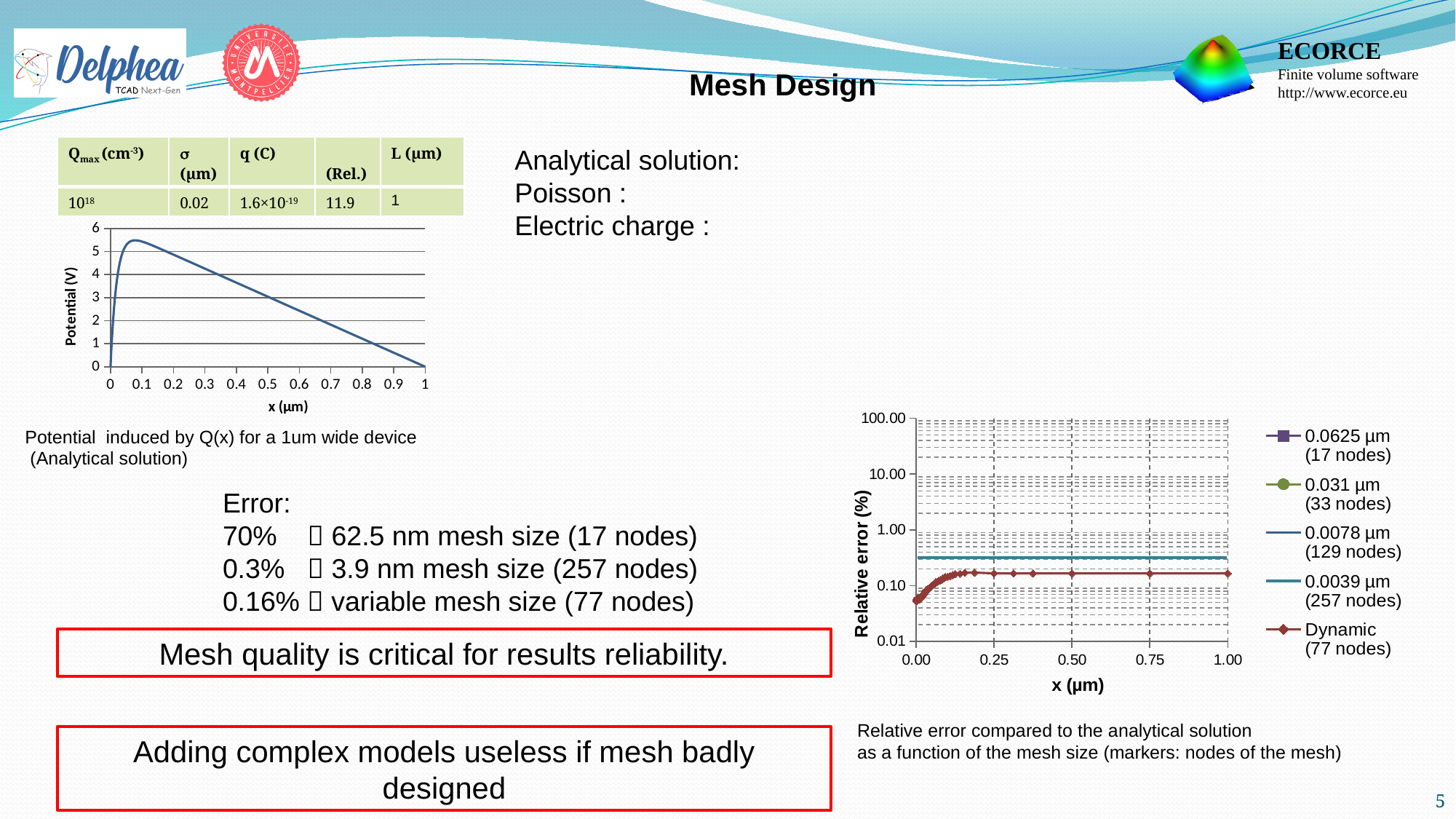
In the right Relative error (%) chart, which series has the larger value at x = 0.50 µm: 0.0039 µm (257 nodes) or Dynamic (77 nodes)? 0.0039 µm (257 nodes) What kind of chart is the left chart showing Potential (V) against x (µm)? line chart In the left Potential (V) chart, is the potential at x = 0.9 µm greater or less than 1 V? less In the left Potential (V) chart, what is the label of the x axis? x (µm) In the left Potential (V) chart, is the peak potential greater or less than 5 V? greater What kind of chart is the right chart showing Relative error (%) against x (µm)? line chart How many series does the legend of the right Relative error (%) chart list? 5 In the right Relative error (%) chart, what is the highest value shown on the y axis? 100.00 In the left Potential (V) chart, what is the potential at x = 1 µm? 0 In the right Relative error (%) chart, is the value of the 0.0039 µm (257 nodes) series at x = 0.50 µm greater or less than 0.10%? greater In the left Potential (V) chart, does the potential rise or fall between x = 0.2 µm and x = 1 µm? fall